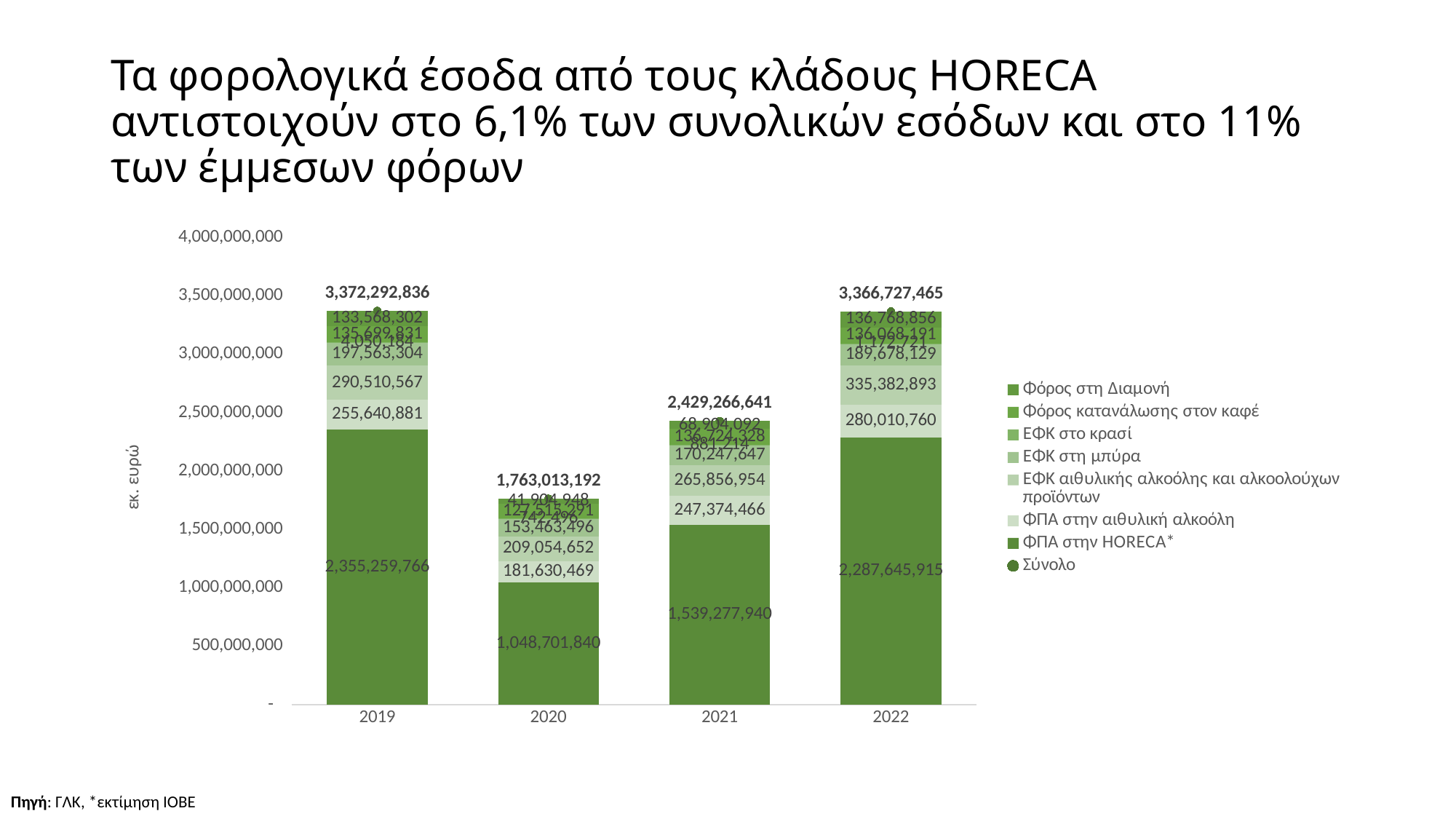
How many years are shown on the x axis? 4 What kind of chart is shown on the slide? Stacked bar chart Which year has the larger total, 2020 or 2021? 2021 What is the total (Σύνολο) value shown for 2020? 1,763,013,192 What is the total (Σύνολο) value shown for 2019? 3,372,292,836 Is the total for 2020 greater or less than 2,000,000,000? less What is the value of ΕΦΚ αιθυλικής αλκοόλης και αλκοολούχων προϊόντων for 2022? 335,382,893 How many entries does the legend list? 8 What is the value of ΦΠΑ στην HORECA* for 2021? 1,539,277,940 Which year has the lowest total (Σύνολο)? 2020 What is the value of ΕΦΚ στη μπύρα for 2020? 153,463,496 What is the difference between the total for 2019 and the total for 2022? 5,565,371